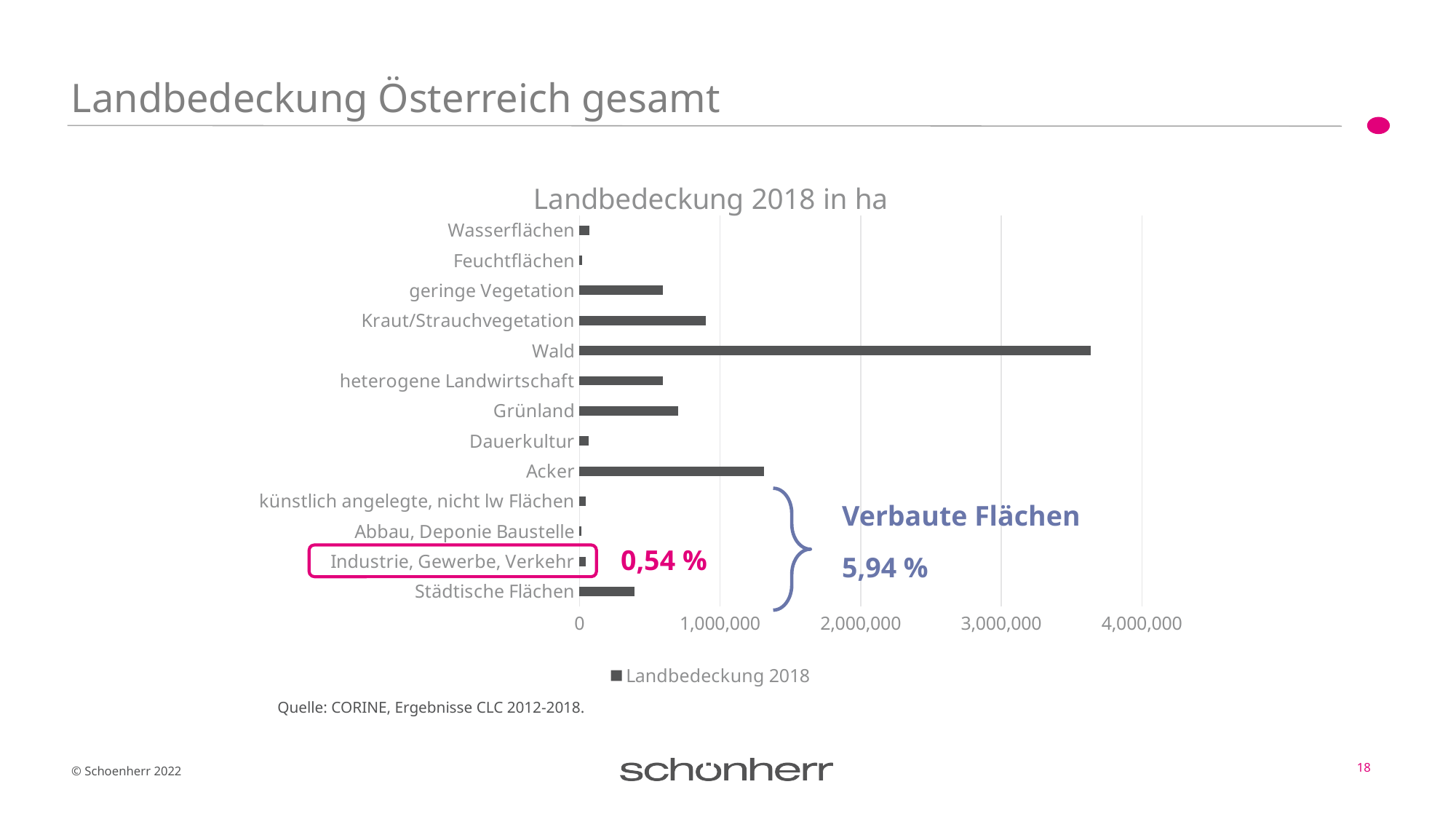
Which category has the highest value in the chart? Wald How many categories are shown on the chart's vertical axis? 13 Is the value for Grünland greater or less than 1,000,000? less What is the title of the chart? Landbedeckung 2018 in ha Is the value for Wald greater or less than 3,000,000? greater What type of chart is shown on the slide? bar chart Which is larger, the value for Acker or the value for Grünland? Acker Is the value for Acker greater or less than 1,000,000? greater How many series does the legend list? 1 What percentage is annotated next to the highlighted category Industrie, Gewerbe, Verkehr? 0,54 % What percentage is given for the group labelled Verbaute Flächen? 5,94 % Which is larger, the value for Kraut/Strauchvegetation or the value for geringe Vegetation? Kraut/Strauchvegetation